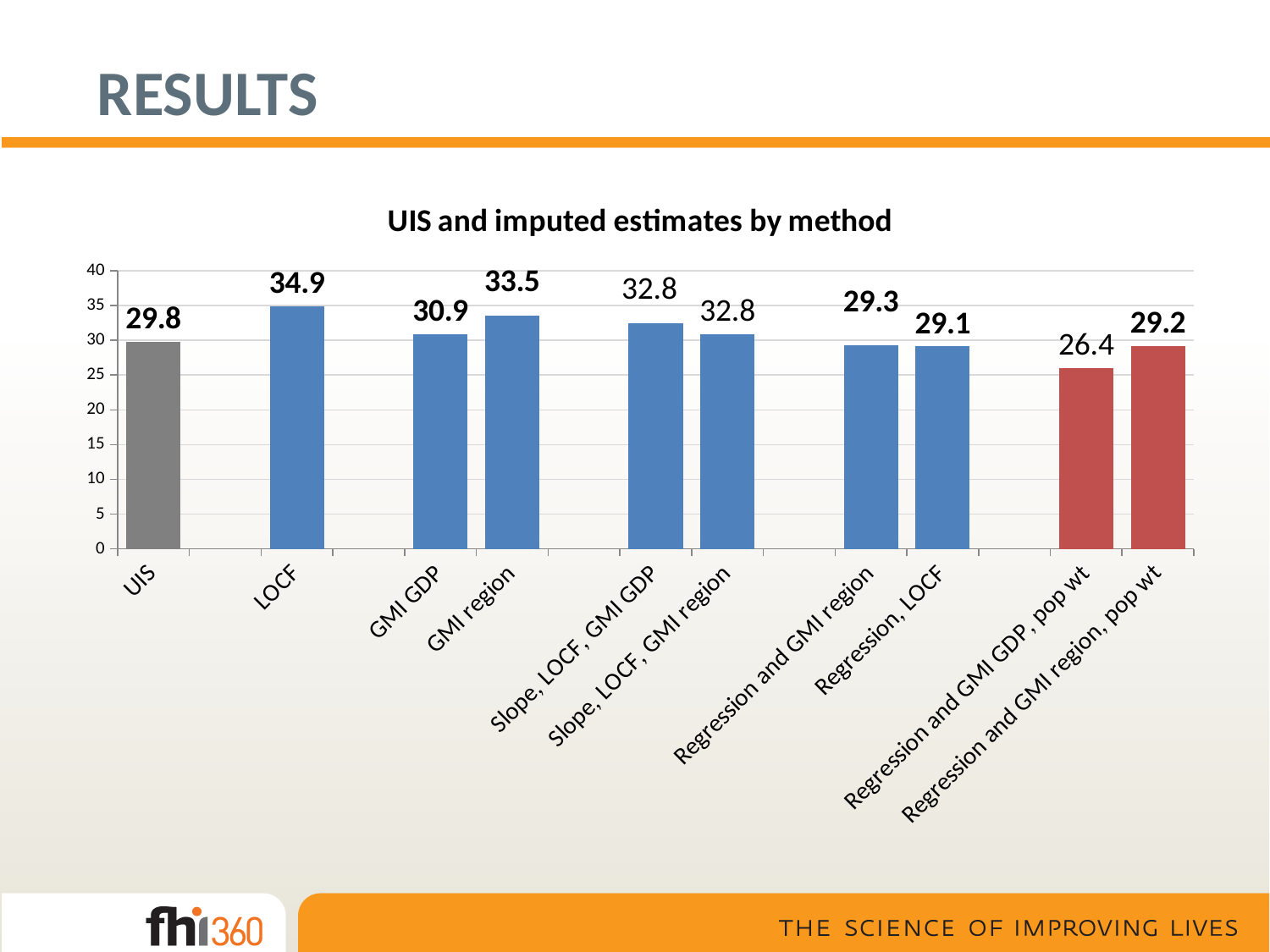
What is the value for UIS? 29.8 What is the value for Slope, LOCF, GMI region? 32.8 Which is larger, the value for GMI GDP or the value for GMI region? GMI region What is the value for Regression and GMI GDP, pop wt? 26.4 What is the difference between the values for LOCF and UIS? 5.1 What kind of chart is shown on the slide? bar chart Is the value for Regression, LOCF greater or less than 30? less Which method has the highest value? LOCF Which method has the lowest value? Regression and GMI GDP, pop wt How many bars are shown in the chart? 10 What is the title of the chart? UIS and imputed estimates by method What is the value for LOCF? 34.9